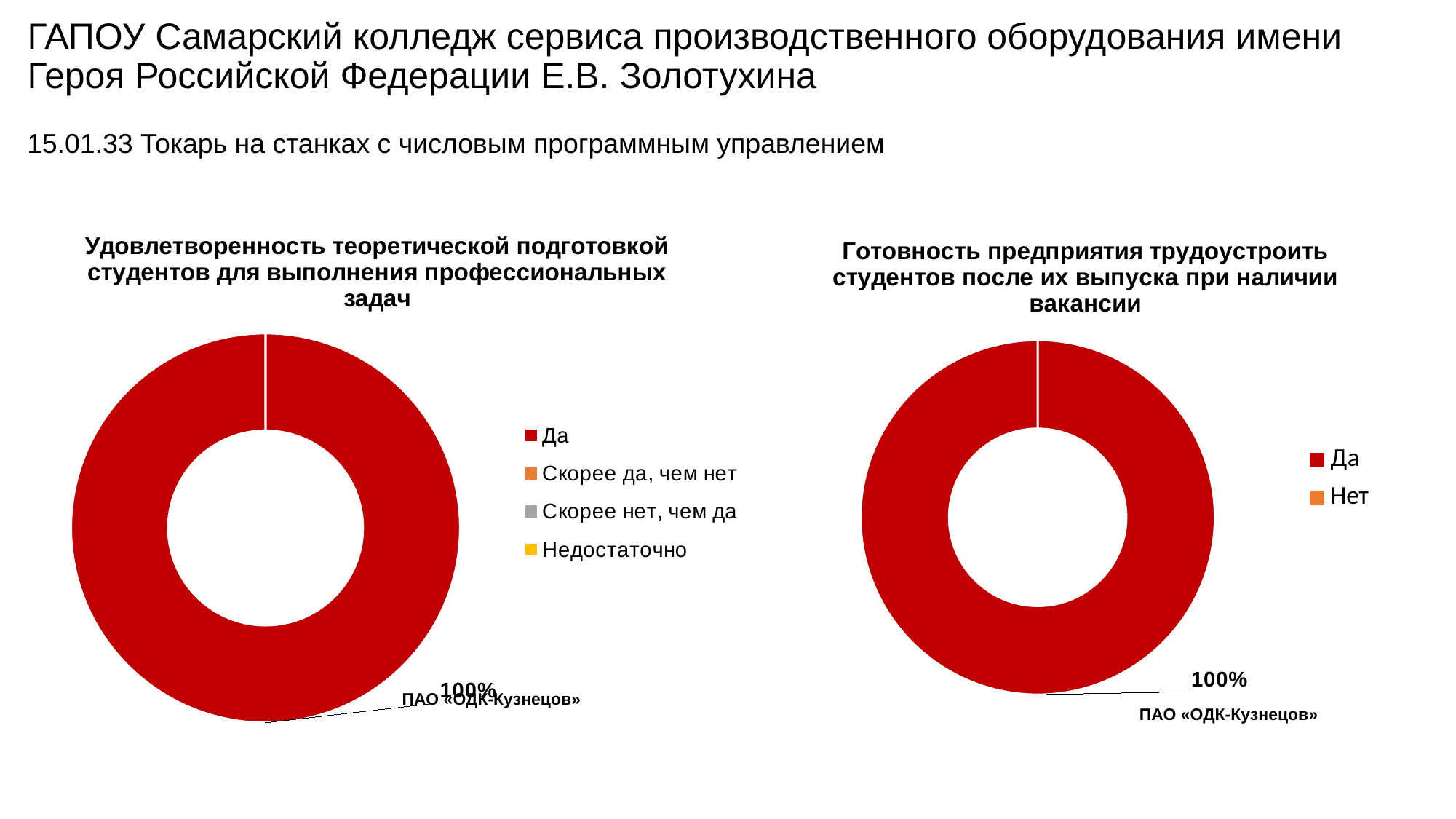
How many entries does the legend of the left chart list? 4 In the left chart, what value is printed as the data label on the doughnut? 100% What kind of chart is the left chart titled «Удовлетворенность теоретической подготовкой студентов для выполнения профессиональных задач»? doughnut chart In the left chart, which answer category has the largest slice? Да How many entries does the legend of the right chart list? 2 In the right chart, what colour is the «Да» slice? red In the right chart, which answer category has the largest slice? Да In the left chart, which legend entry is shown in yellow? Недостаточно In the right chart, which enterprise is named in the data label next to the 100% value? ПАО «ОДК-Кузнецов» In the right chart, what share of the doughnut does the «Да» slice take? 100% What kind of chart is the right chart titled «Готовность предприятия трудоустроить студентов после их выпуска при наличии вакансии»? doughnut chart In the left chart, what share of the doughnut does the «Да» slice take? 100%